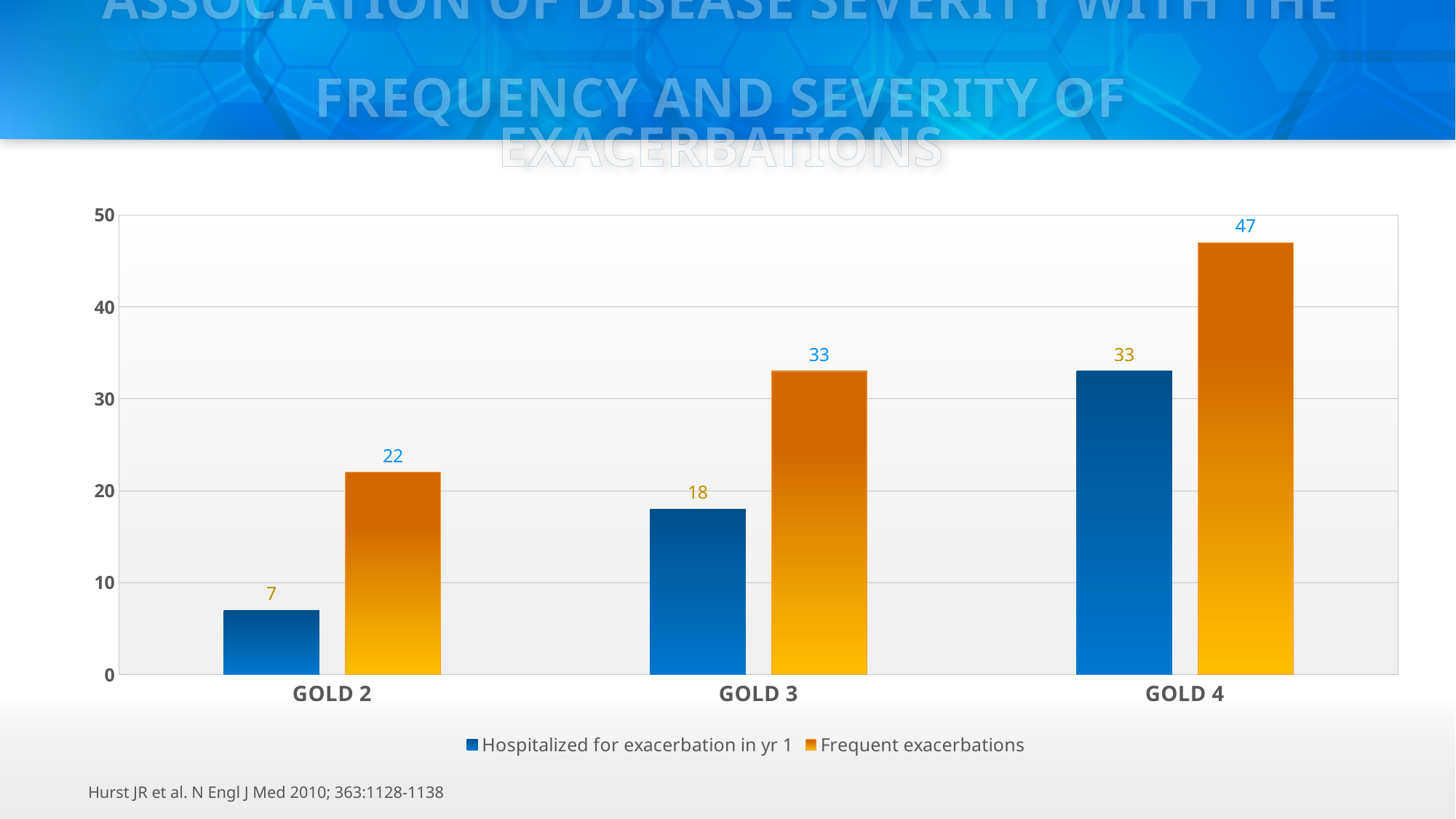
Which category has the lowest value for 'Hospitalized for exacerbation in yr 1'? GOLD 2 What is the value for 'Frequent exacerbations' at GOLD 4? 47 Which is larger at GOLD 2: 'Frequent exacerbations' or 'Hospitalized for exacerbation in yr 1'? Frequent exacerbations What is the value for 'Hospitalized for exacerbation in yr 1' at GOLD 2? 7 How many categories are shown on the x axis? 3 Which category has the highest value for 'Frequent exacerbations'? GOLD 4 Is the value for 'Frequent exacerbations' at GOLD 4 greater or less than 40? greater Do the values for 'Hospitalized for exacerbation in yr 1' rise or fall from GOLD 2 to GOLD 4? Rise What kind of chart is shown on the slide? Bar chart How many series does the legend list? 2 What is the value for 'Hospitalized for exacerbation in yr 1' at GOLD 3? 18 What is the difference between 'Frequent exacerbations' and 'Hospitalized for exacerbation in yr 1' at GOLD 3? 15